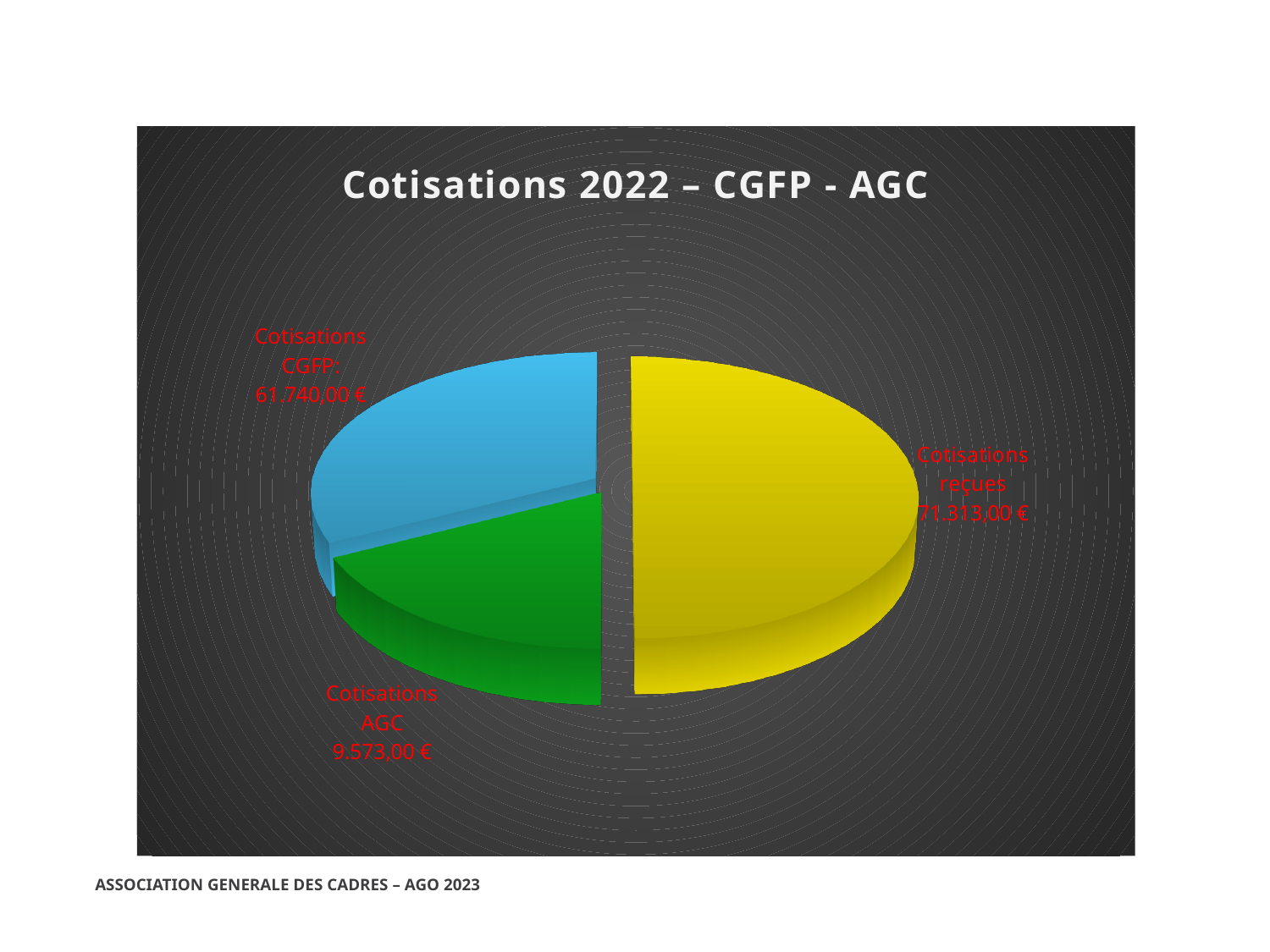
What is the value for Cotisations AGC? 9.573,00 € Which slice has the largest value? Cotisations reçues Which is larger, Cotisations CGFP or Cotisations AGC? Cotisations CGFP What is the title of the chart? Cotisations 2022 – CGFP - AGC Which slice has the smallest value? Cotisations AGC What is the value for Cotisations reçues? 71.313,00 € What is the value for Cotisations CGFP? 61.740,00 € What colour is the Cotisations AGC slice? green How many slices does the pie chart have? 3 What is the difference between Cotisations CGFP and Cotisations AGC? 52.167,00 € What kind of chart is shown on the slide? pie chart What is the difference between Cotisations reçues and Cotisations CGFP? 9.573,00 €